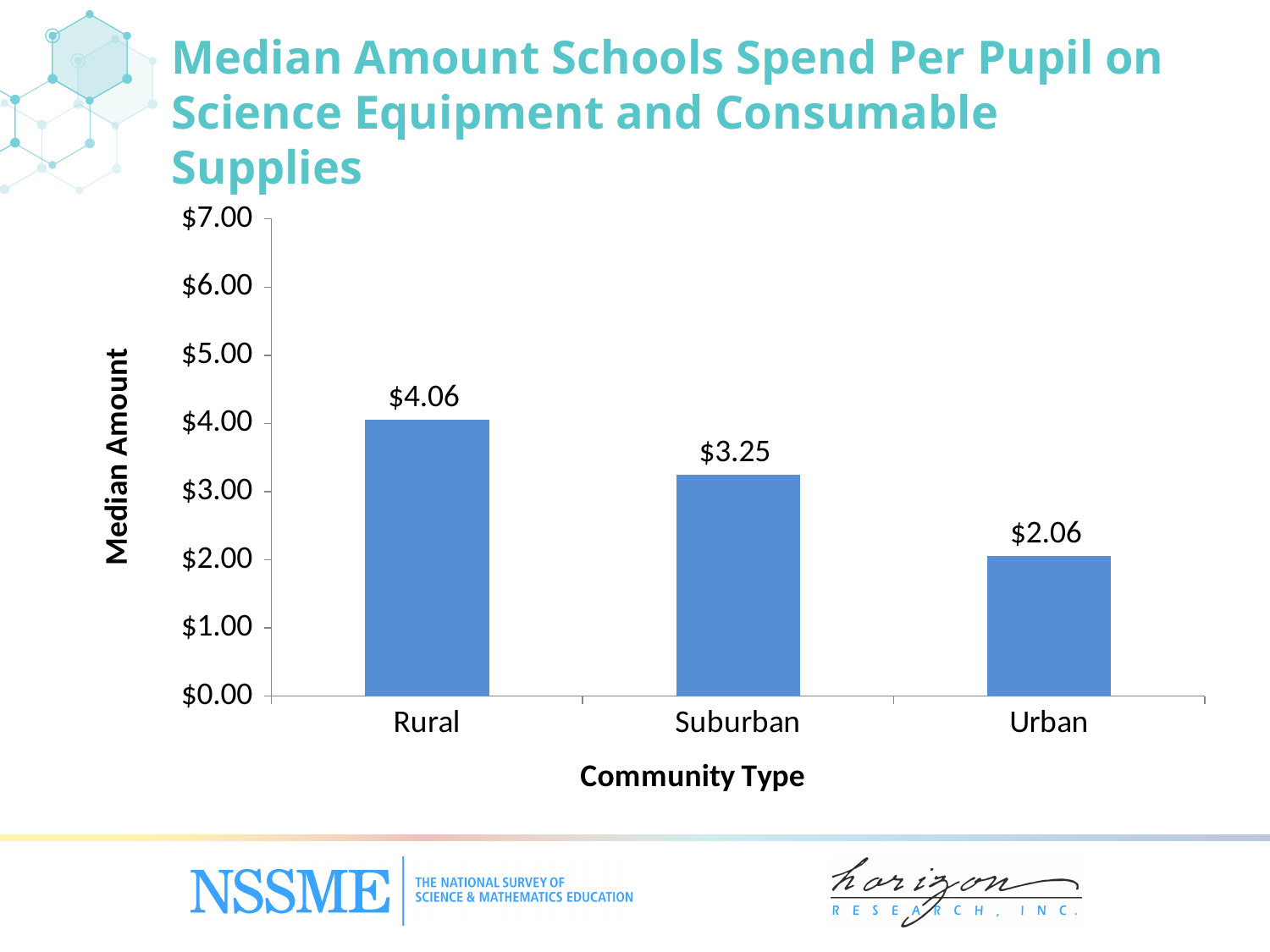
What is the median amount spent per pupil for Urban schools? $2.06 What is the median amount spent per pupil for Suburban schools? $3.25 Is the value for Suburban greater or less than $3.00? greater What is the label of the x axis? Community Type How many community types are shown on the chart? 3 What is the difference between the median amounts for Rural and Urban schools? $2.00 Which community type has the lowest median amount spent per pupil? Urban Which is larger, the median amount for Suburban or Urban schools? Suburban What is the difference between the median amounts for Rural and Suburban schools? $0.81 What kind of chart is shown on the slide? Bar chart What is the median amount spent per pupil for Rural schools? $4.06 Which community type has the highest median amount spent per pupil? Rural